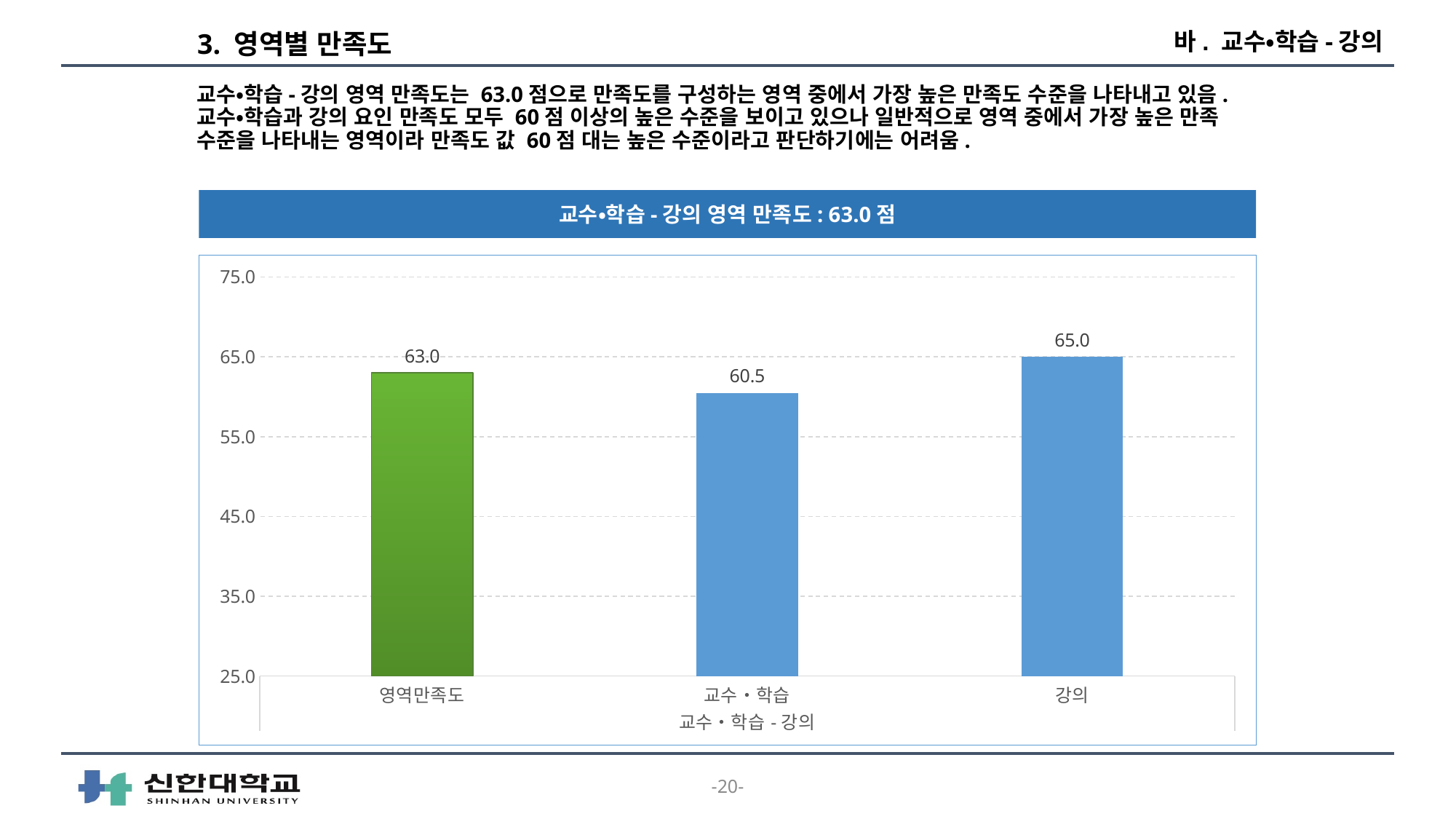
What is the value for 영역만족도? 63.0 What is the value for 강의? 65.0 Which category has the lowest value? 교수·학습 Is the value for 교수·학습 greater or less than 65.0? less What is the value for 교수·학습? 60.5 What kind of chart is shown on the slide? bar chart How many bars are shown in the chart? 3 Which is larger, the value for 영역만족도 or the value for 교수·학습? 영역만족도 Which category has the highest value? 강의 What is the difference between the values for 강의 and 교수·학습? 4.5 What is the difference between the values for 강의 and 영역만족도? 2.0 What is the label shown below the category axis of the chart? 교수·학습 - 강의